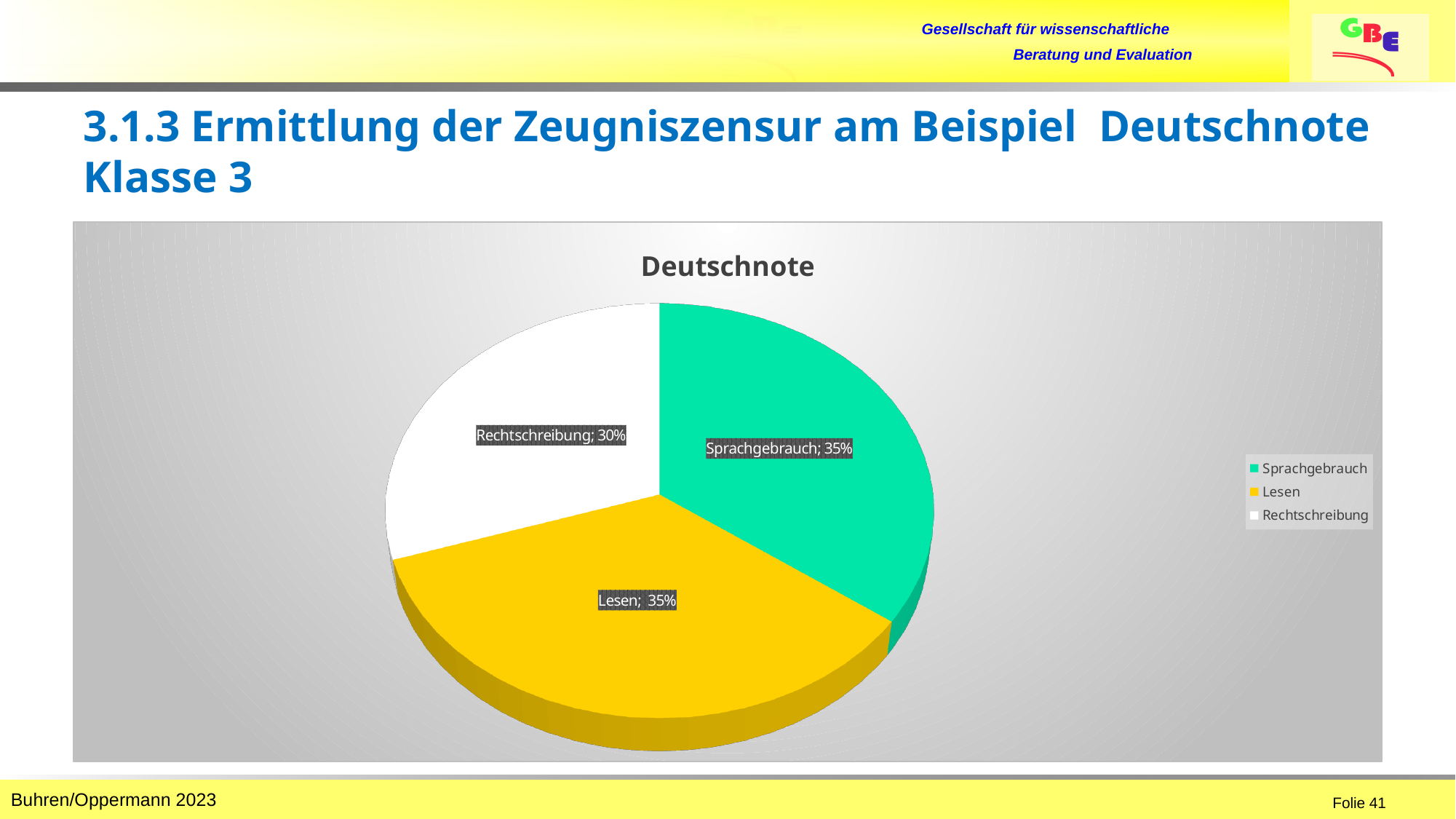
What share of the pie does Sprachgebrauch have? 35% How many entries does the legend list? 3 How many slices does the pie chart have? 3 What is the combined share of Sprachgebrauch and Lesen? 70% What share of the pie does Rechtschreibung have? 30% What share of the pie does Lesen have? 35% What kind of chart is shown on the slide? Pie chart Which is larger, the share of Lesen or the share of Rechtschreibung? Lesen What is the difference between the shares of Sprachgebrauch and Rechtschreibung? 5% What is the title of the chart? Deutschnote Which category has the smallest slice of the pie? Rechtschreibung Which category is shown in yellow? Lesen